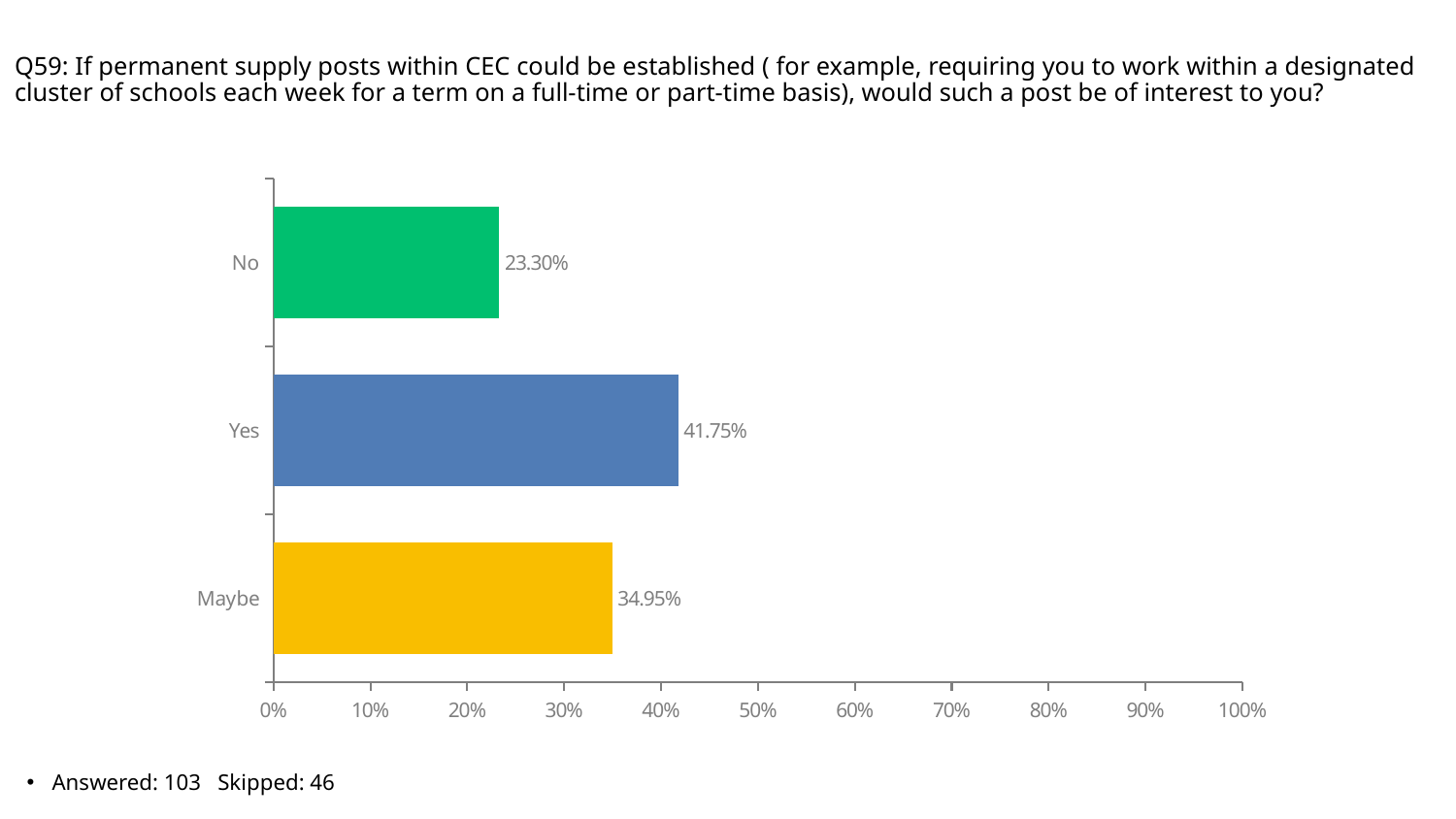
Is the value for "Yes" greater or less than 40%? greater What percentage of respondents answered "Yes"? 41.75% What kind of chart is shown on the slide? Bar chart What is the difference in percentage points between "Yes" and "No"? 18.45 What percentage of respondents answered "No"? 23.30% Which response category has the lowest percentage? No What percentage of respondents answered "Maybe"? 34.95% How many response categories are shown in the chart? 3 What colour is the bar for "Maybe"? Yellow Which is larger, the percentage for "Maybe" or the percentage for "No"? Maybe What is the difference in percentage points between "Yes" and "Maybe"? 6.80 Which response category has the highest percentage? Yes